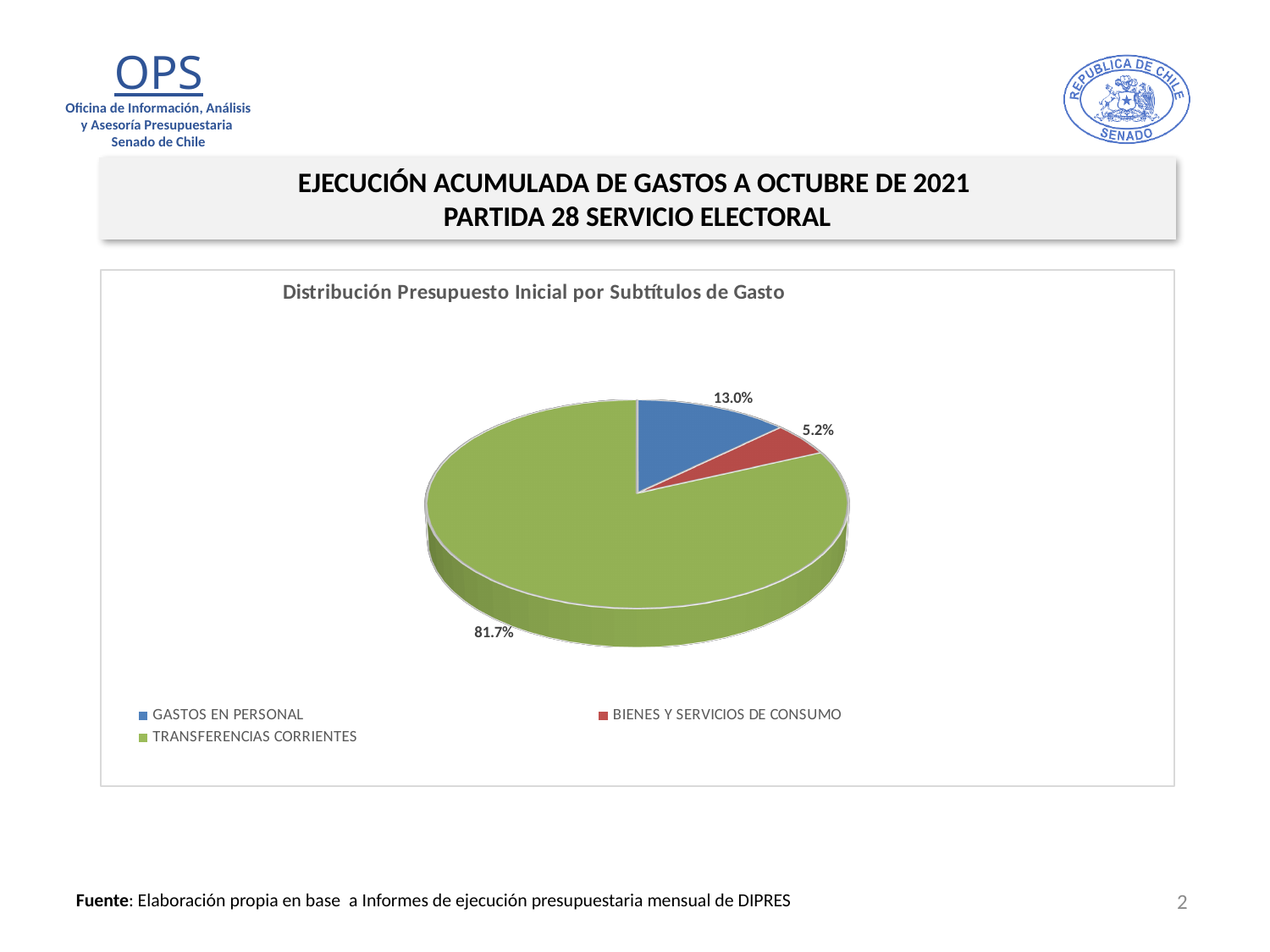
Which category has the smallest slice of the pie? BIENES Y SERVICIOS DE CONSUMO How many categories does the pie chart show? 3 What is the difference in percentage points between the TRANSFERENCIAS CORRIENTES slice and the GASTOS EN PERSONAL slice? 68.7 percentage points Which category has the largest slice of the pie? TRANSFERENCIAS CORRIENTES What share of the pie does BIENES Y SERVICIOS DE CONSUMO represent? 5.2% What is the difference in percentage points between the GASTOS EN PERSONAL slice and the BIENES Y SERVICIOS DE CONSUMO slice? 7.8 percentage points Which is larger, the GASTOS EN PERSONAL slice or the BIENES Y SERVICIOS DE CONSUMO slice? GASTOS EN PERSONAL What share of the pie does GASTOS EN PERSONAL represent? 13.0% What kind of chart is shown on the slide? Pie chart What share of the pie does TRANSFERENCIAS CORRIENTES represent? 81.7% What colour is the TRANSFERENCIAS CORRIENTES slice? Green What is the title of the chart? Distribución Presupuesto Inicial por Subtítulos de Gasto